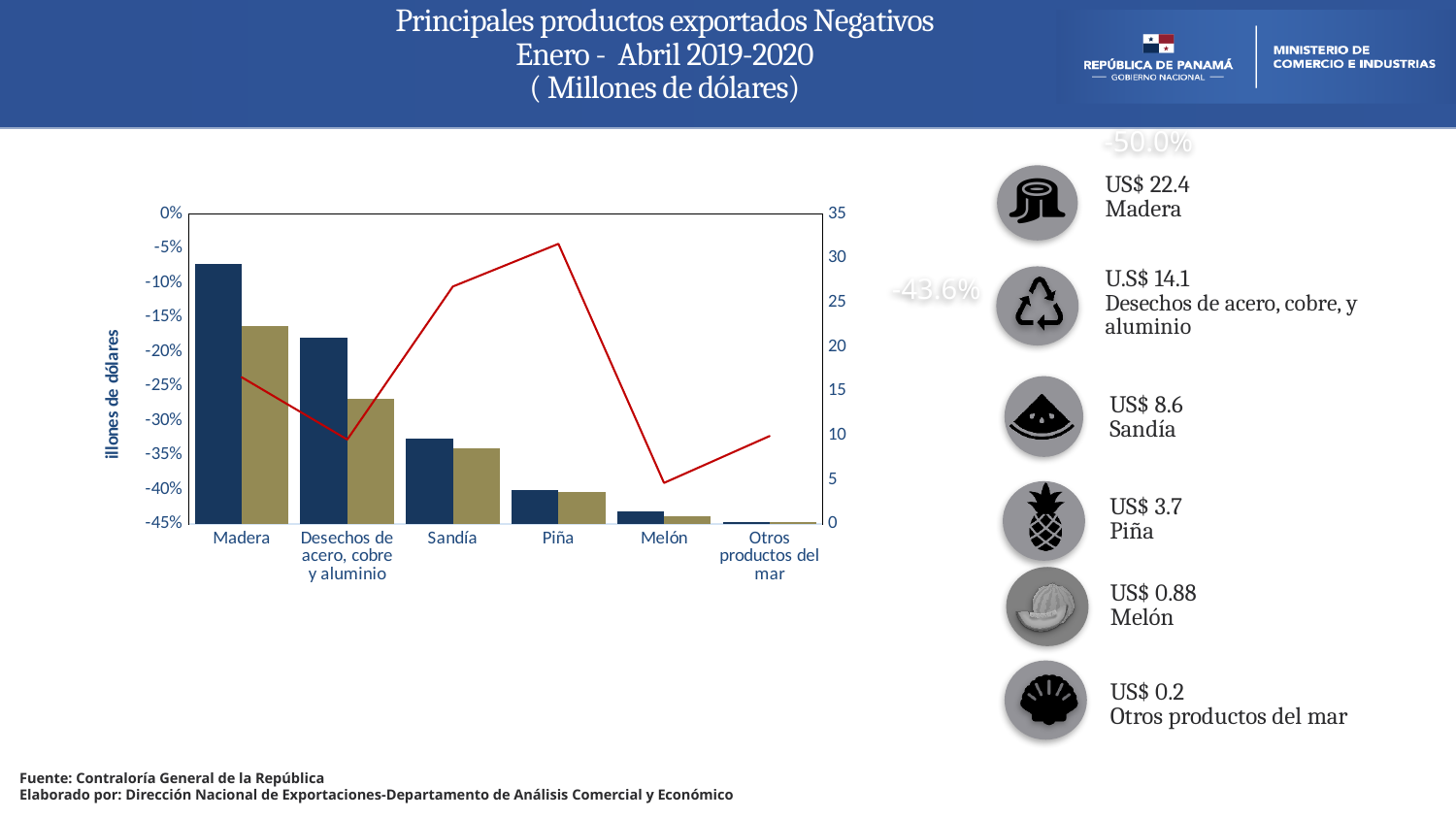
What kind of chart is shown on the slide? A bar chart combined with a line How many categories are shown on the x axis of the chart? 6 What is the title of the slide containing the chart? Principales productos exportados Negativos Enero - Abril 2019-2020 ( Millones de dólares) Which category has the tallest bars in the chart? Madera On the right-hand axis, is the dark blue bar for Madera greater or less than 25? greater Which category has the shortest bars in the chart? Otros productos del mar On the right-hand axis, is the dark blue bar for Piña greater or less than 5? less At which category does the red line reach its lowest point? Melón Do the bar heights rise or fall moving from left to right along the x axis? Fall Are the bars for Madera taller or shorter than the bars for Sandía? Taller At which category does the red line reach its highest point? Piña